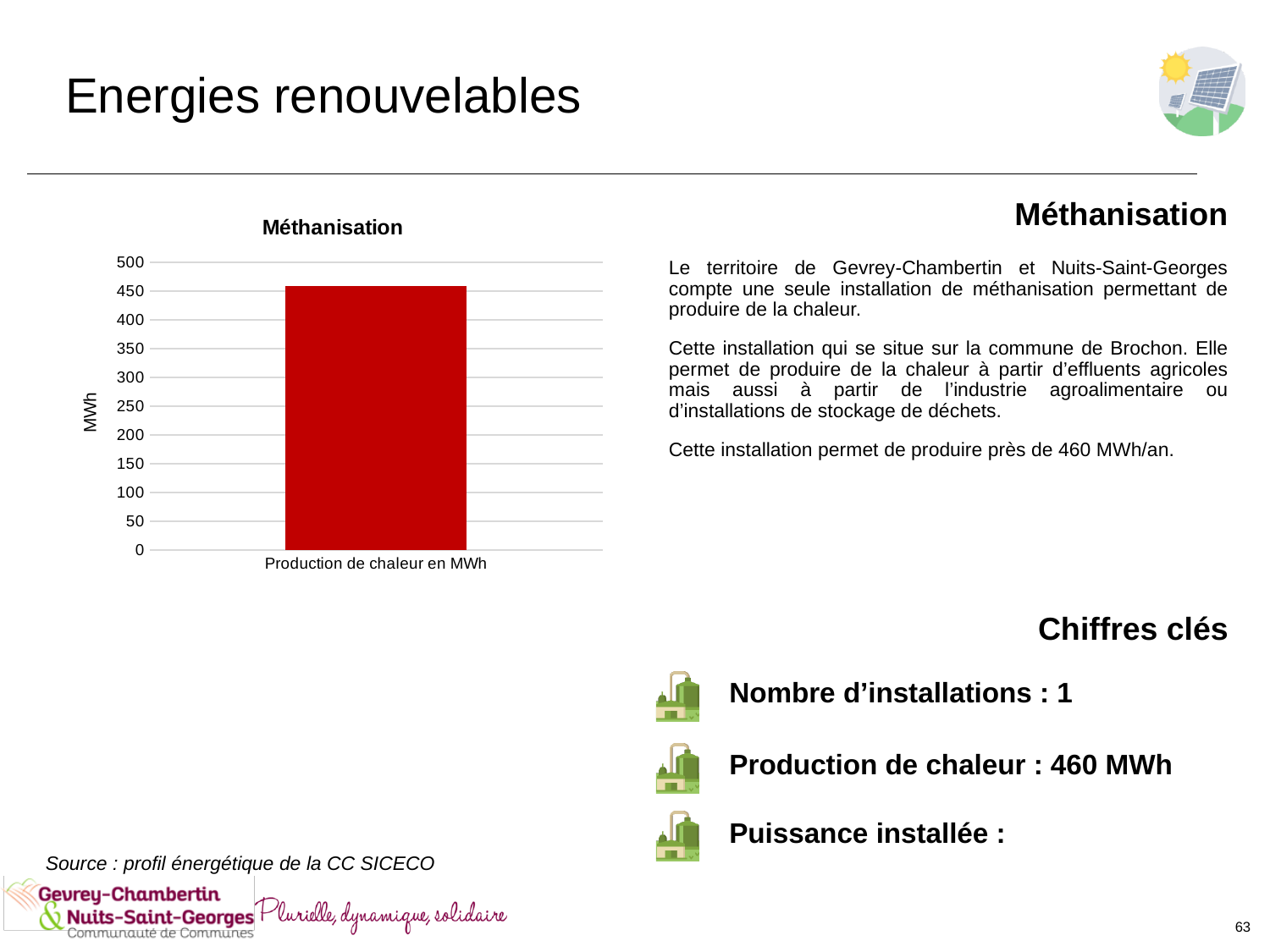
Is the value for Production de chaleur en MWh greater or less than 250? greater What kind of chart is shown on the slide? bar chart Is the value for Production de chaleur en MWh greater or less than 400? greater How many bars does the chart show? 1 What is the maximum value shown on the y axis of the chart? 500 What is the title of the chart? Méthanisation Is the value for Production de chaleur en MWh greater or less than 500? less What is the label of the category on the x axis of the chart? Production de chaleur en MWh